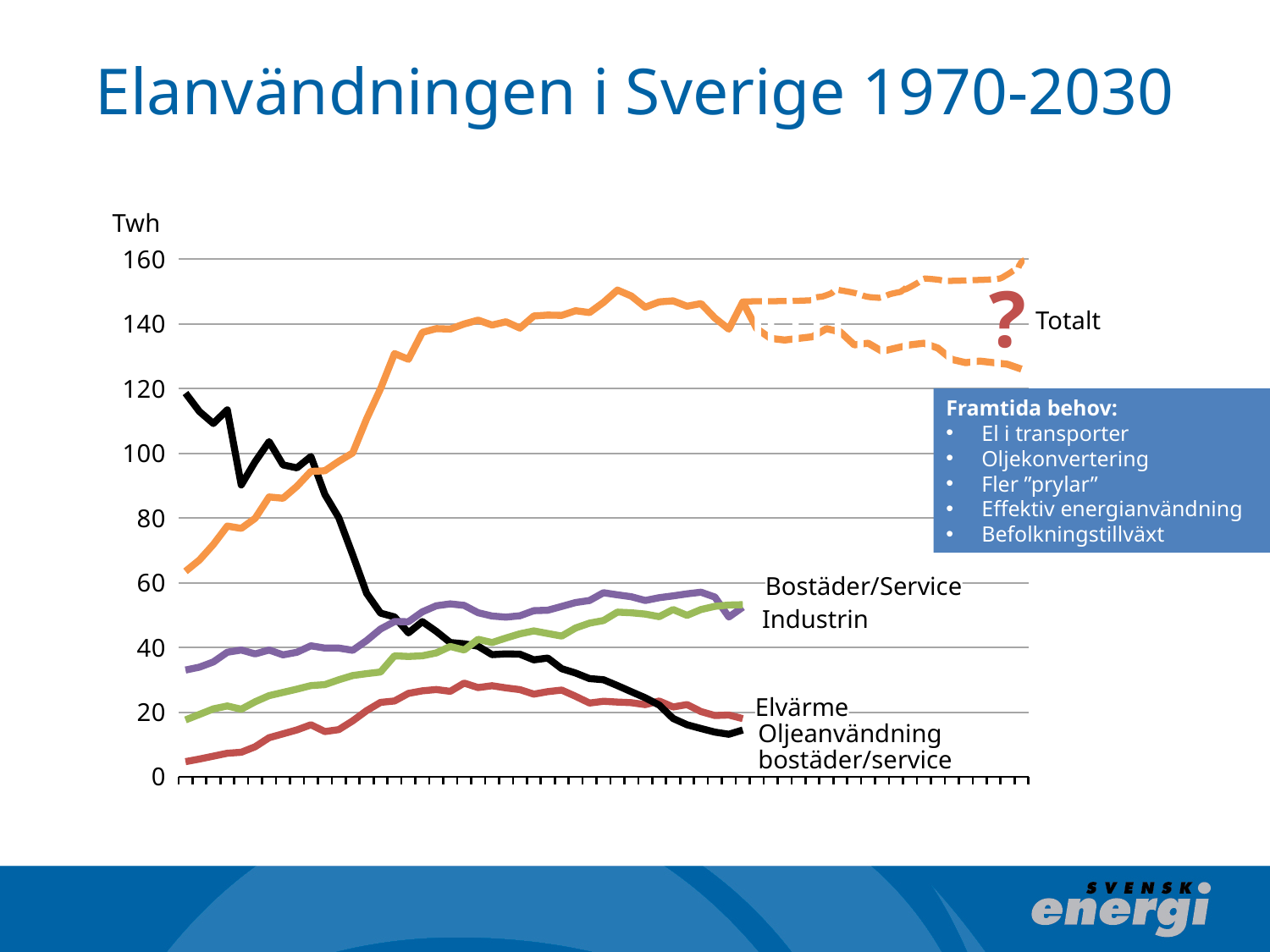
Is the highest point of the solid Totalt line greater or less than 140? greater Is the value of the Elvärme line at the start of the chart (1970) greater or less than 20? less Is the value of the Oljeanvändning bostäder/service line at the start of the chart (1970) greater or less than 100? greater At the start of the chart (1970), which is larger: Oljeanvändning bostäder/service or Totalt? Oljeanvändning bostäder/service Does the Oljeanvändning bostäder/service line rise or fall over the period shown? fall What is the title of the chart on the slide? Elanvändningen i Sverige 1970-2030 Does the Totalt line rise or fall from 1970 to the end of the solid line? rise What unit is shown on the y axis of the chart? Twh Which series has the lowest value at the start of the chart (1970)? Elvärme What kind of chart is shown on the slide? line chart How many data series are labelled on the chart? 5